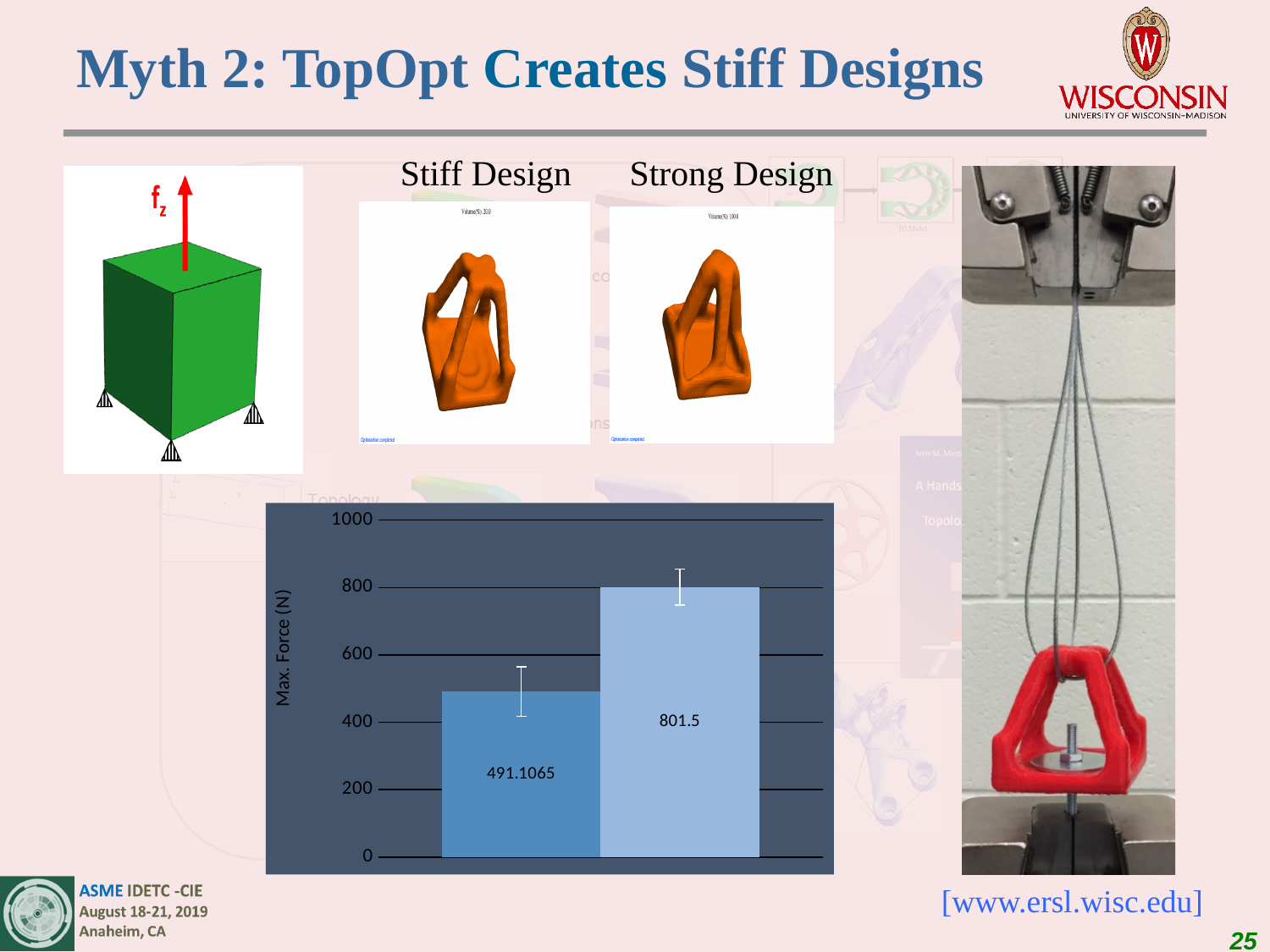
What is the highest tick value shown on the vertical axis of the chart? 1000 Is the value of the left bar greater or less than the value of the right bar? less What is the label on the vertical axis of the chart? Max. Force (N) Which bar in the chart has the lowest value? the left bar (491.1065) Which bar in the chart is taller, the left bar or the right bar? the right bar How many bars are plotted in the chart? 2 What value is printed on the right bar of the bar chart? 801.5 What value is printed on the left bar of the bar chart? 491.1065 What is the difference between the values of the right bar and the left bar in the chart? 310.3935 Is the value of the left bar greater or less than 400? greater Is the value of the right bar greater or less than 600? greater What kind of chart is shown on the slide? bar chart